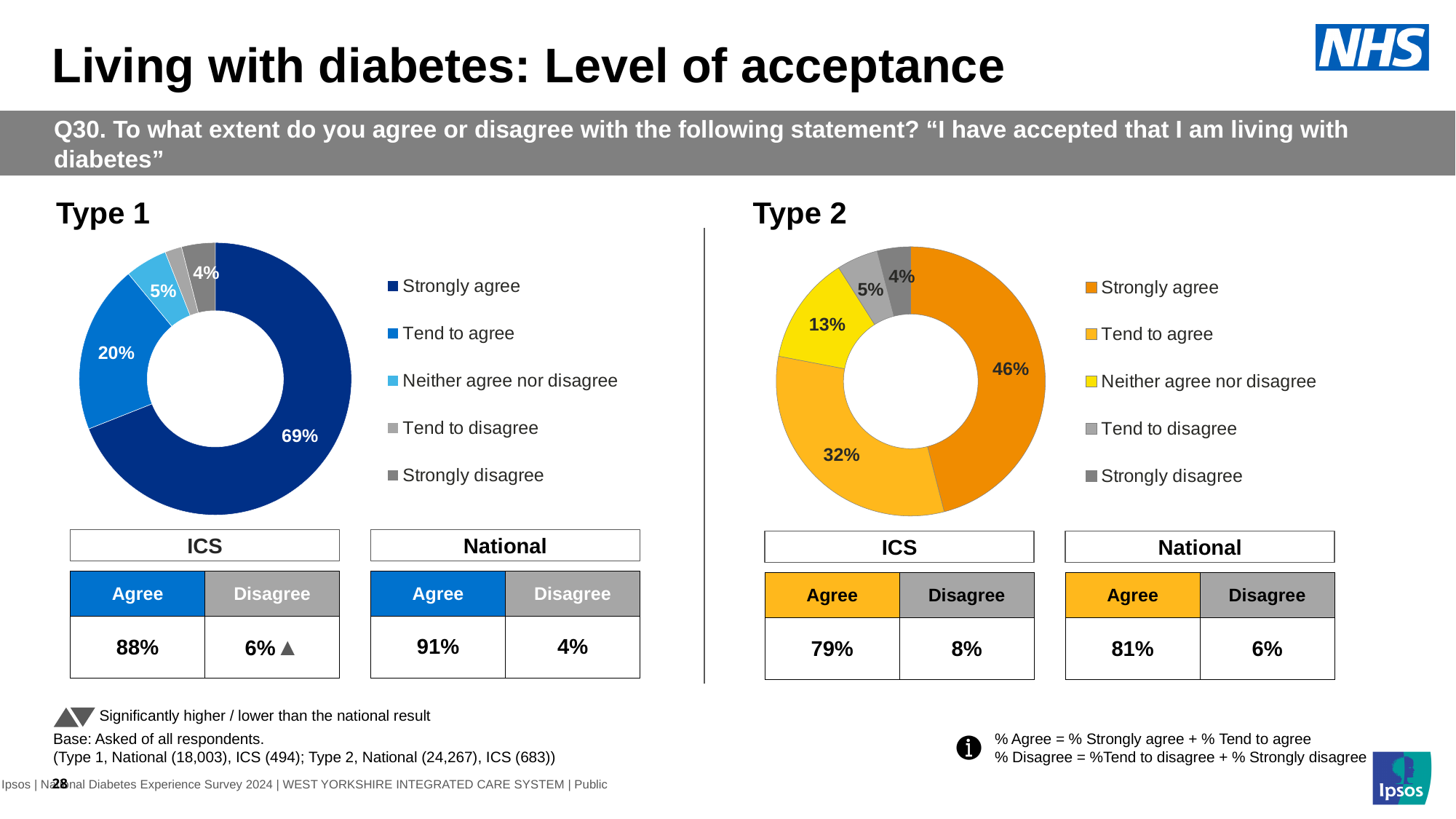
On the Type 2 chart, what is the combined share of Strongly agree and Tend to agree? 78% On the Type 2 chart, which response category has the smallest share? Strongly disagree On the Type 1 chart, what percentage of respondents tend to agree? 20% How many response categories does the legend of the Type 1 chart list? 5 On the Type 2 chart, what percentage of respondents tend to agree? 32% Which is larger: the Strongly agree share on the Type 1 chart or the Strongly agree share on the Type 2 chart? Type 1 On the Type 2 chart, what percentage of respondents neither agree nor disagree? 13% On the Type 1 chart, what percentage of respondents strongly agree? 69% On the Type 1 chart, what is the difference between the Strongly agree and Tend to agree shares? 49 percentage points What kind of chart is used for the Type 2 results? Donut (pie) chart On the Type 1 chart, what colour represents Strongly agree? Dark blue On the Type 2 chart, which response category has the largest share? Strongly agree